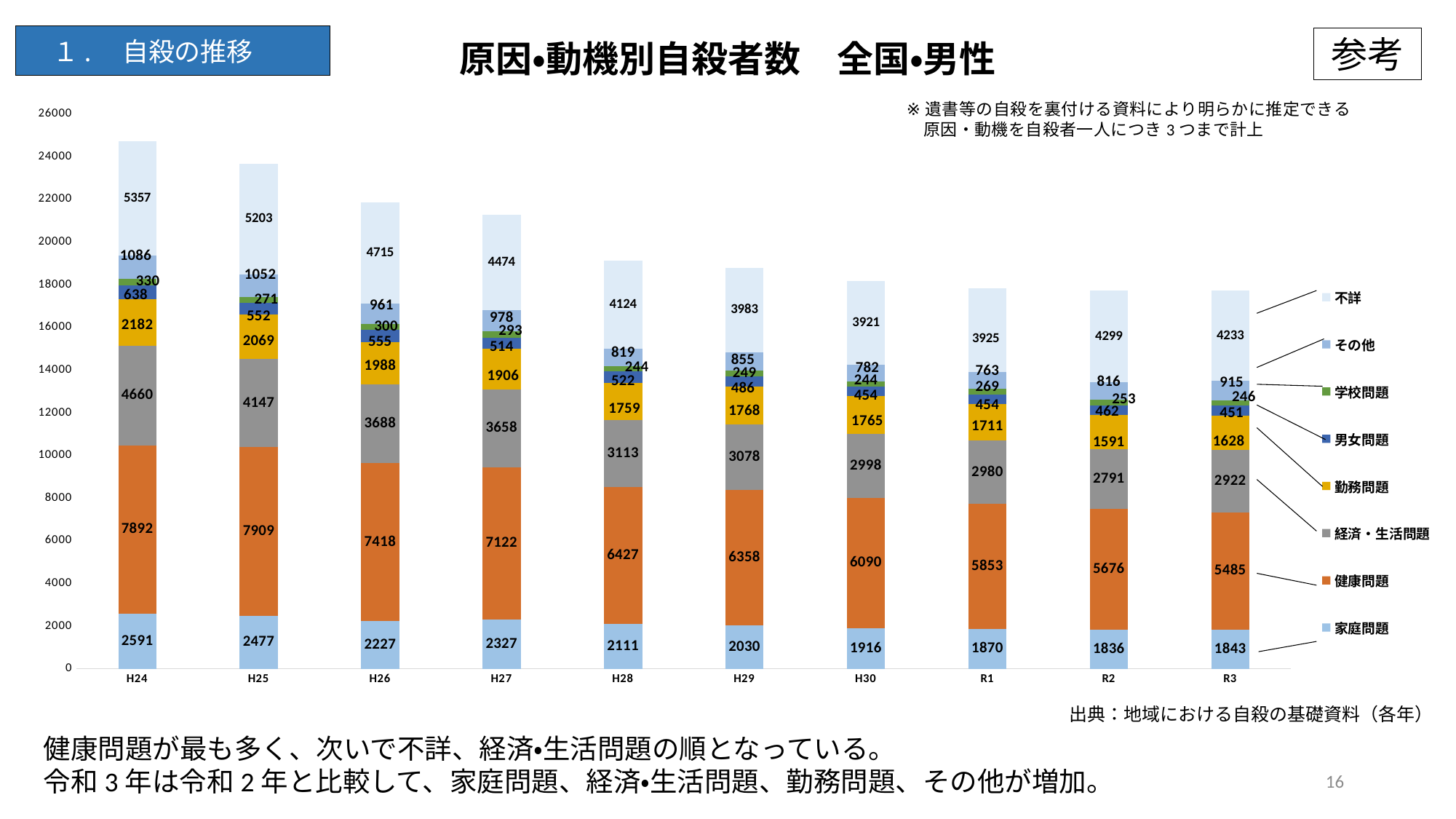
In which year is the value for 不詳 the highest? H24 How many series does the legend list? 8 What is the value for 不詳 in H25? 5203 What is the value for 勤務問題 in H28? 1759 What is the difference between the 健康問題 values for H24 and R3? 2407 What is the value for 健康問題 in H24? 7892 In which year is the value for 健康問題 the lowest? R3 What is the value for 家庭問題 in R3? 1843 Which is larger in H24, 経済・生活問題 or 勤務問題? 経済・生活問題 How many years are shown on the x axis? 10 What is the total of the stacked bar for R3? 17723 Does the value for 健康問題 rise or fall from H24 to R3? fall